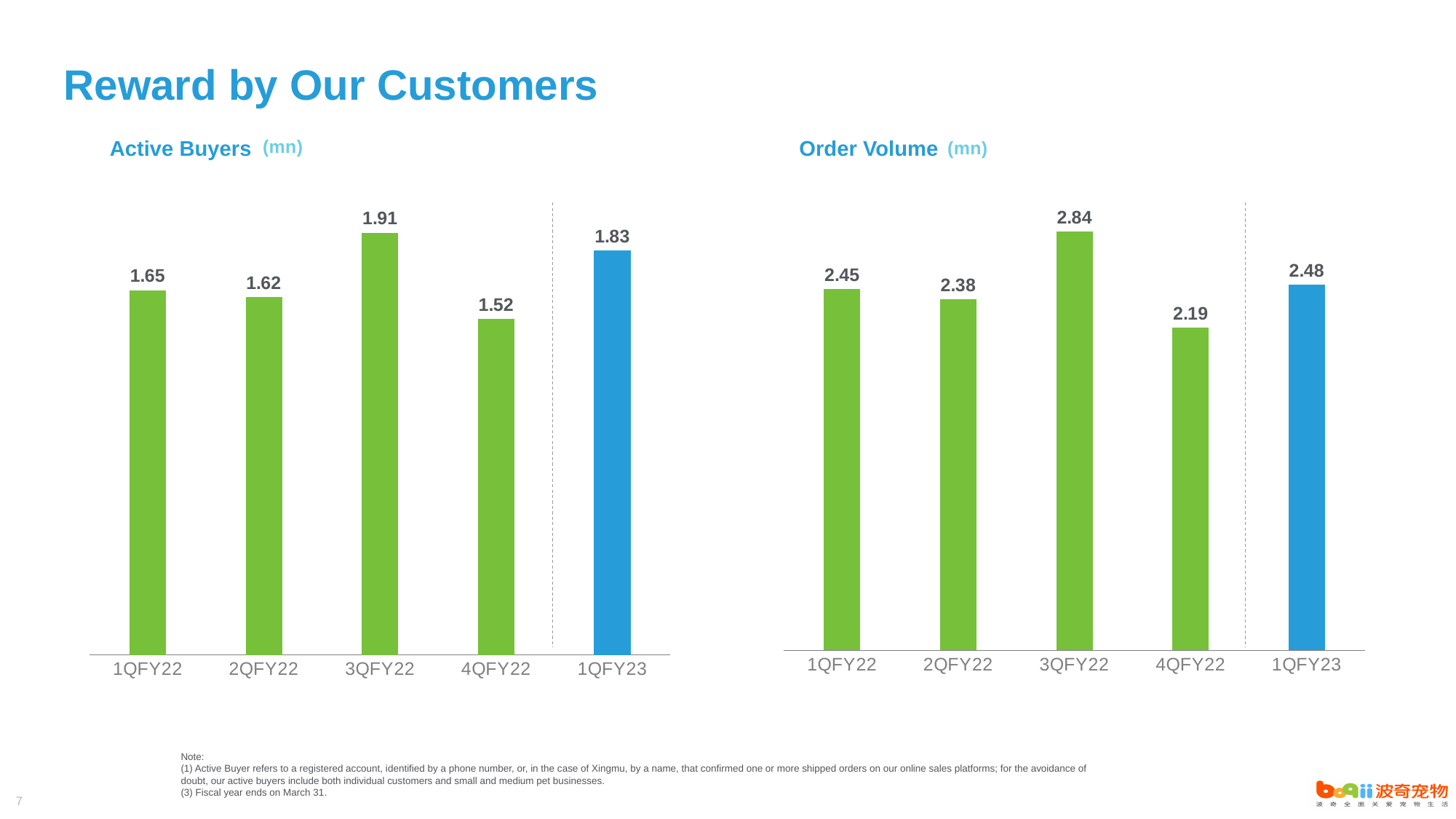
In the Active Buyers chart, what is the value for 3QFY22? 1.91 In the Active Buyers chart, which quarter has the lowest value? 4QFY22 In the Active Buyers chart, what is the difference between 3QFY22 and 4QFY22? 0.39 In the Order Volume chart, what is the value for 1QFY23? 2.48 In the Order Volume chart, which quarter has the highest value? 3QFY22 In the Active Buyers chart, what unit is shown next to the chart title? mn In the Active Buyers chart, which is larger, 1QFY23 or 1QFY22? 1QFY23 What type of chart is the Order Volume chart? Bar chart How many quarters are shown in the Active Buyers chart? 5 In the Order Volume chart, which is larger, 1QFY22 or 2QFY22? 1QFY22 In the Order Volume chart, what is the difference between 1QFY23 and 4QFY22? 0.29 In the Order Volume chart, what colour is the 1QFY23 bar? Blue